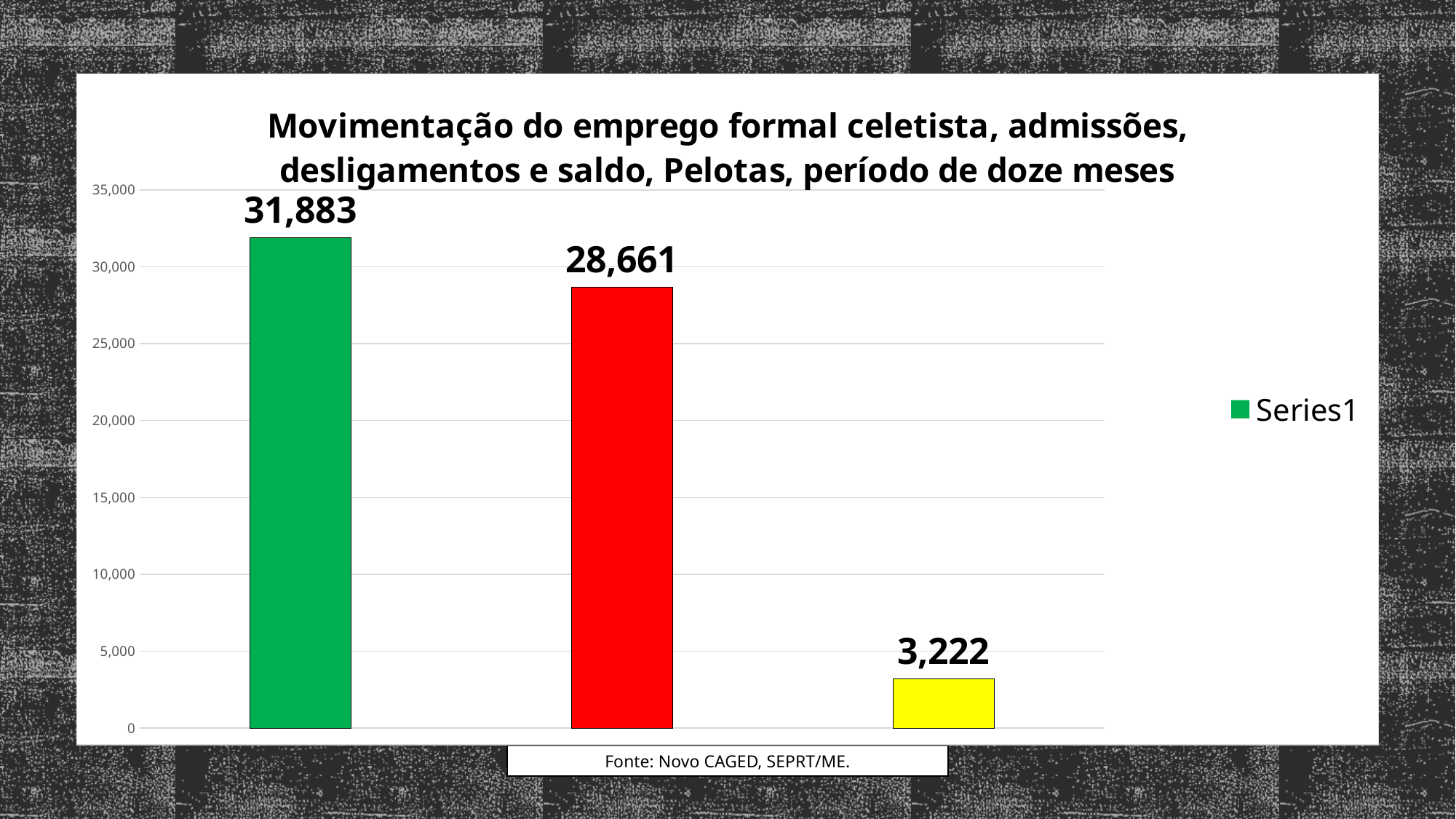
What kind of chart is shown on the slide? Bar chart What is the difference between the green bar and the red bar? 3,222 How many bars are plotted in the chart? 3 Which is larger, the value of the green bar or the value of the red bar? The green bar Which bar has the highest value? The green bar (first from the left), 31,883 What is the name of the series listed in the legend? Series1 Which bar has the lowest value? The yellow bar (rightmost), 3,222 What is the value of the yellow bar (the rightmost bar)? 3,222 Is the value of the yellow bar greater or less than 5,000? less What is the value of the red bar (the middle bar)? 28,661 What is the difference between the red bar and the yellow bar? 25,439 What is the value of the green bar (the first bar from the left)? 31,883